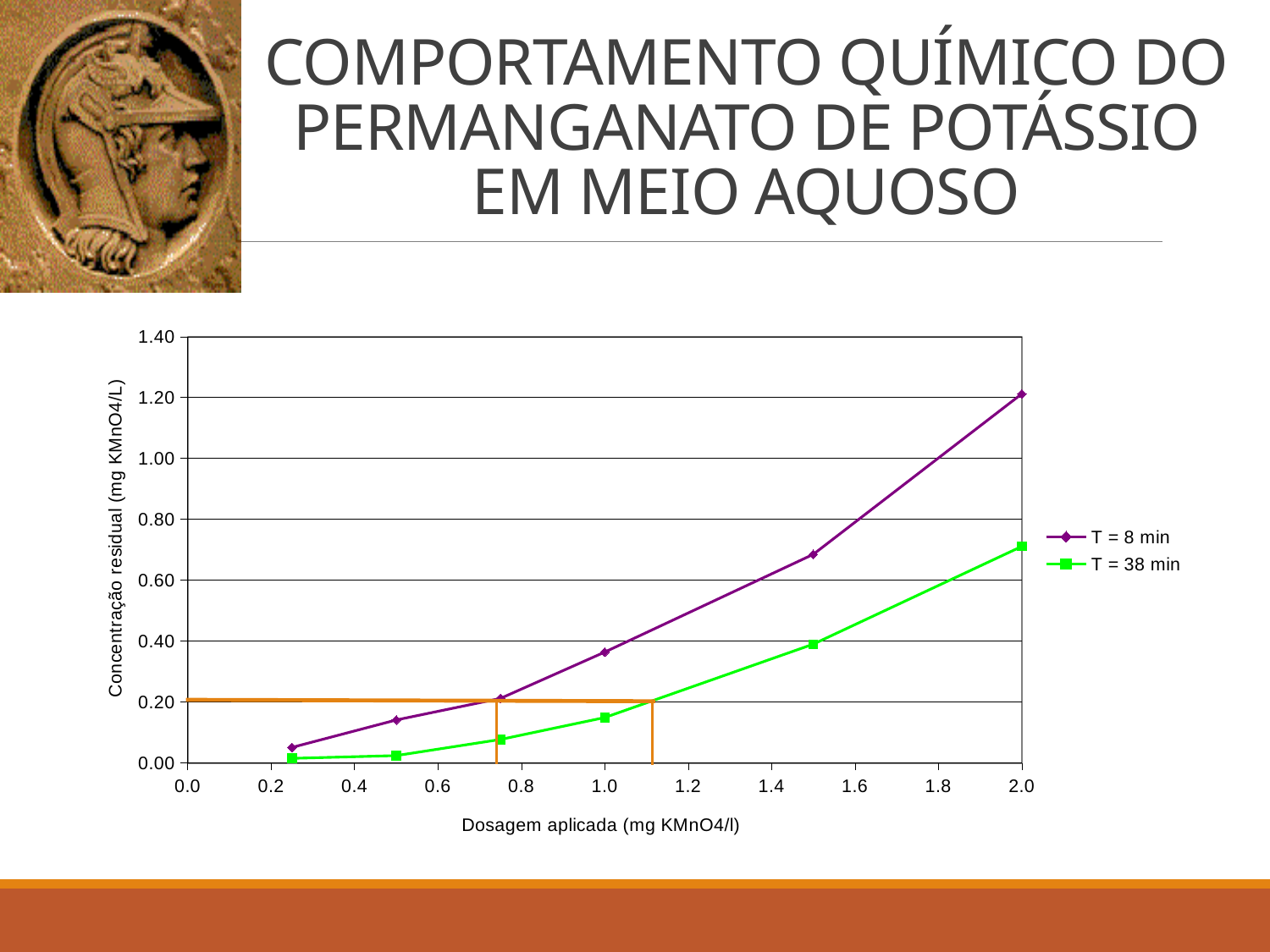
At a dosage of 2.0, which series has the higher residual concentration, T = 8 min or T = 38 min? T = 8 min Do the values of the T = 38 min series rise or fall as the applied dosage increases? rise How many data points are plotted for the T = 8 min series? 6 What kind of chart is shown on the slide? line chart Is the value for T = 8 min at a dosage of 1.0 greater or less than 0.40? less Do the values of the T = 8 min series rise or fall as the applied dosage increases? rise Is the value for T = 38 min at a dosage of 2.0 greater or less than 0.80? less How many series does the legend list? 2 What is the label of the y axis? Concentração residual (mg KMnO4/L) What is the label of the x axis? Dosagem aplicada (mg KMnO4/l) Is the value for T = 8 min at a dosage of 2.0 greater or less than 1.00? greater